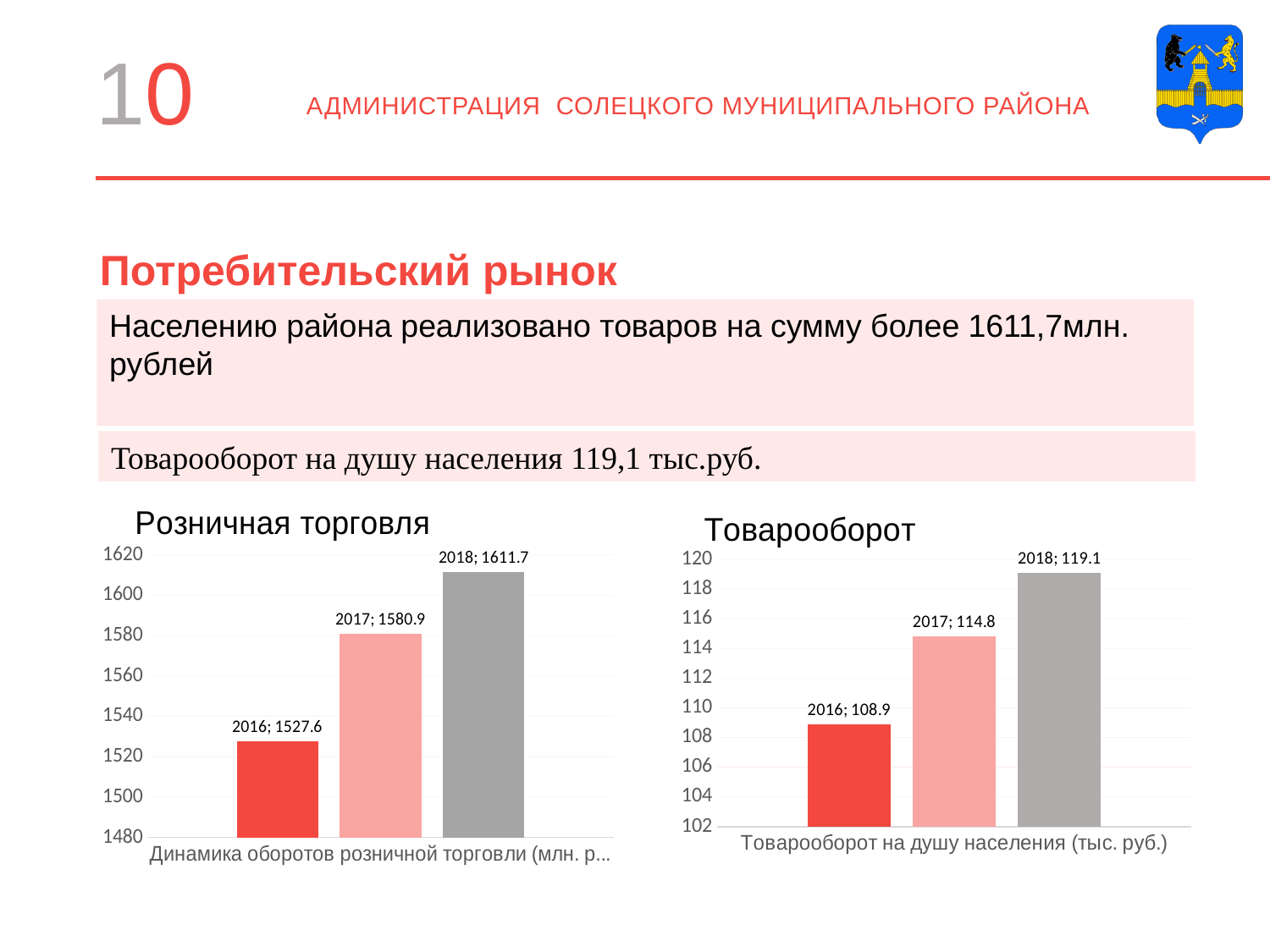
In the 'Розничная торговля' chart, what is the value for 2016? 1527.6 In the 'Розничная торговля' chart, what is the value for 2018? 1611.7 In the 'Товарооборот' chart, what is the value for 2017? 114.8 In the 'Товарооборот' chart, which year has the lowest value? 2016 In the 'Розничная торговля' chart, what is the difference between the 2018 and 2017 values? 30.8 In the 'Товарооборот' chart, what is the difference between the 2018 and 2016 values? 10.2 In the 'Товарооборот' chart, do the values rise or fall from 2016 to 2018? rise What type of chart is the 'Розничная торговля' chart? bar chart How many bars are shown in the 'Товарооборот' chart? 3 In the 'Розничная торговля' chart, is the value for 2017 greater or less than 1560? greater In the 'Розничная торговля' chart, which year has the highest value? 2018 In the 'Товарооборот' chart, what is the value for 2016? 108.9